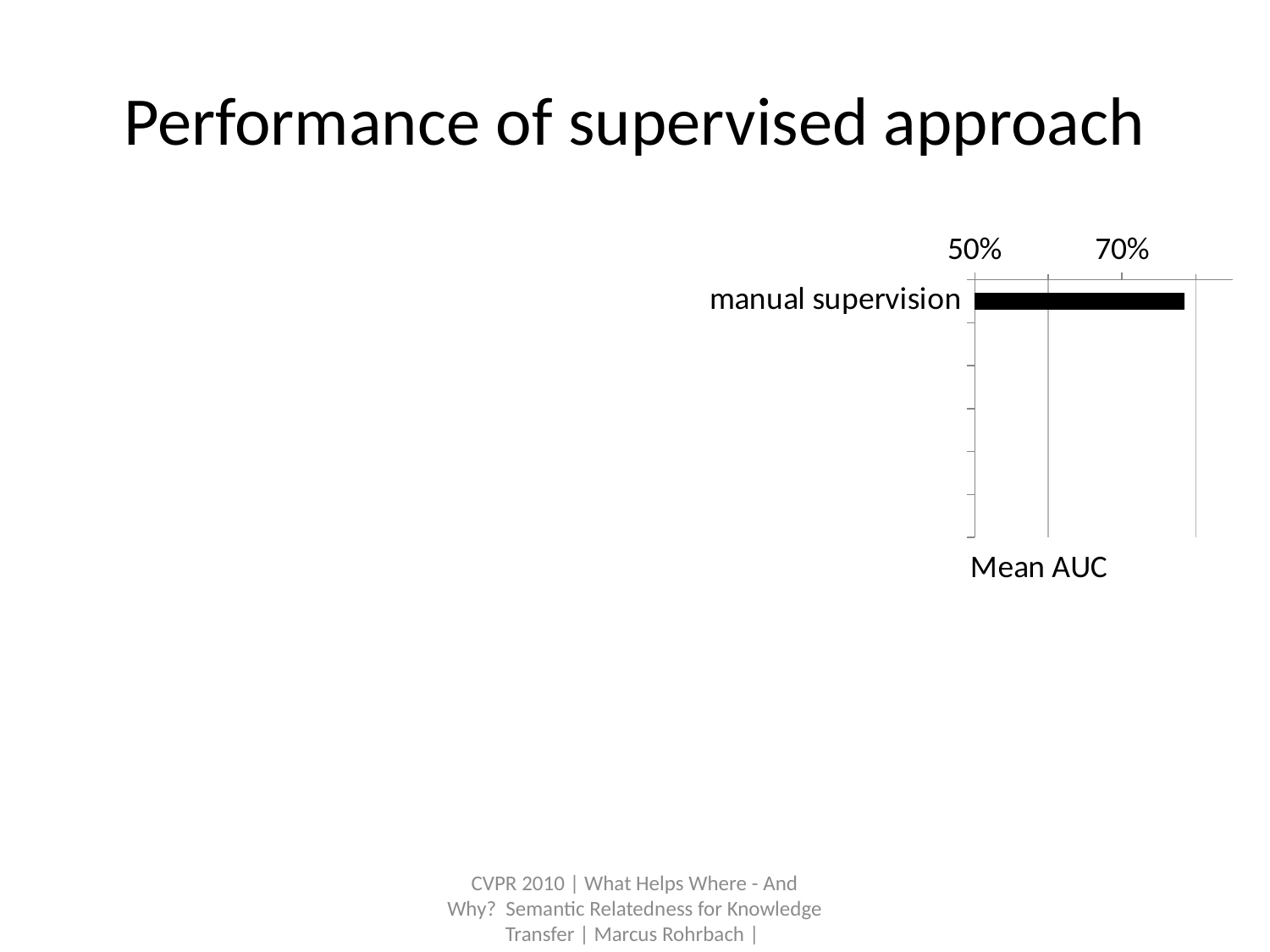
What kind of chart is shown on the slide? bar chart Is the Mean AUC value for manual supervision greater or less than 70%? greater Is the Mean AUC value for manual supervision greater or less than 50%? greater What is the axis title shown below the chart? Mean AUC How many categories are plotted in the chart? 1 What is the label of the only category plotted in the chart? manual supervision